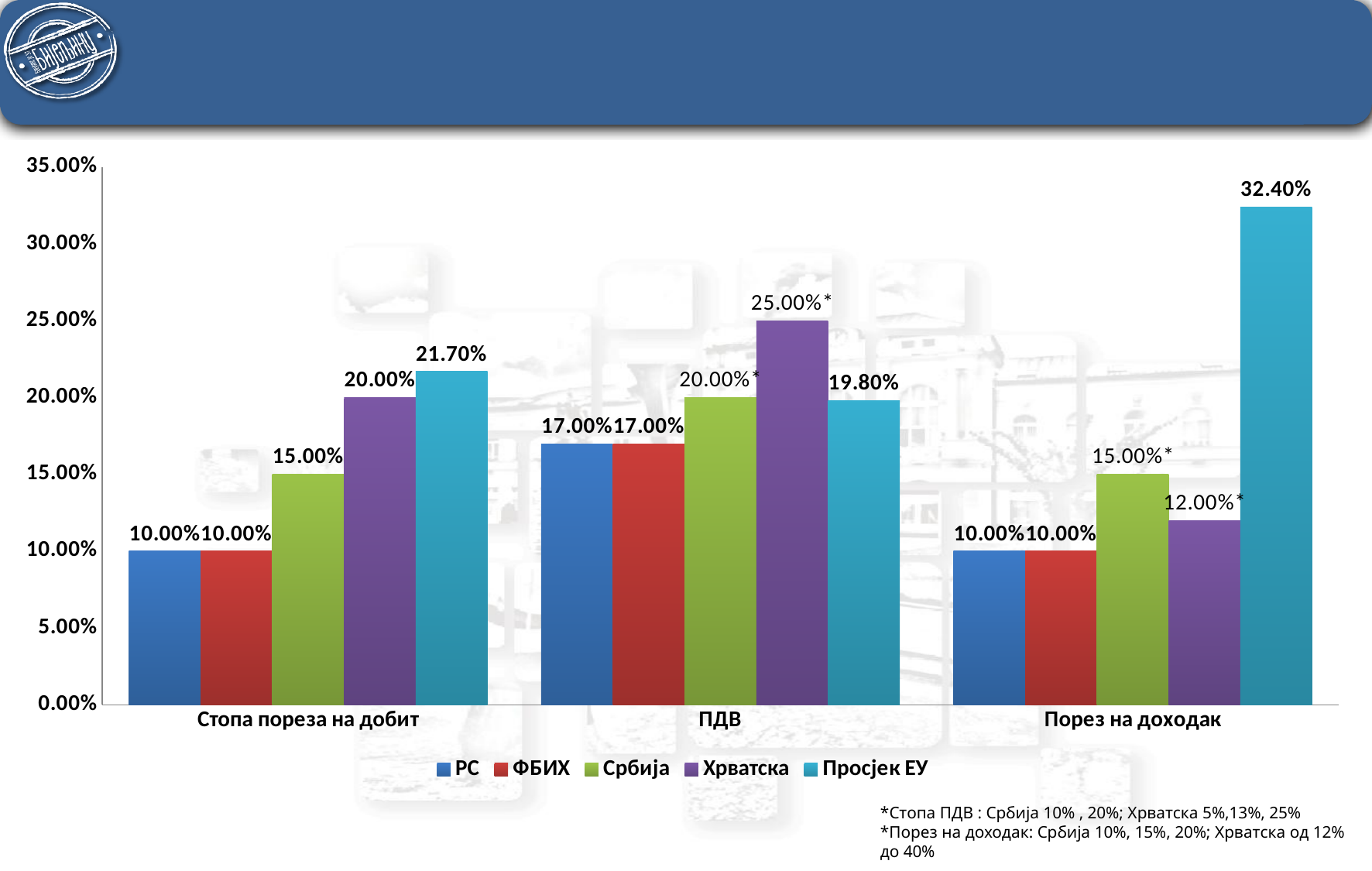
What is the value for Просјек ЕУ in the Порез на доходак category? 32.40% What is the value for Хрватска in the ПДВ category? 25.00% Is the value for Просјек ЕУ in the Порез на доходак category greater or less than 30.00%? greater In the ПДВ category, which is larger: the value for Србија or the value for Просјек ЕУ? Србија How many categories are shown on the x axis? 3 What is the value for Србија in the Стопа пореза на добит category? 15.00% What kind of chart is shown on the slide? bar chart Which series has the highest value in the ПДВ category? Хрватска What is the value for РС in the ПДВ category? 17.00% How many series does the legend list? 5 What is the difference between the Просјек ЕУ value and the Хрватска value in the Стопа пореза на добит category? 1.70% Which series has the highest value in the Порез на доходак category? Просјек ЕУ